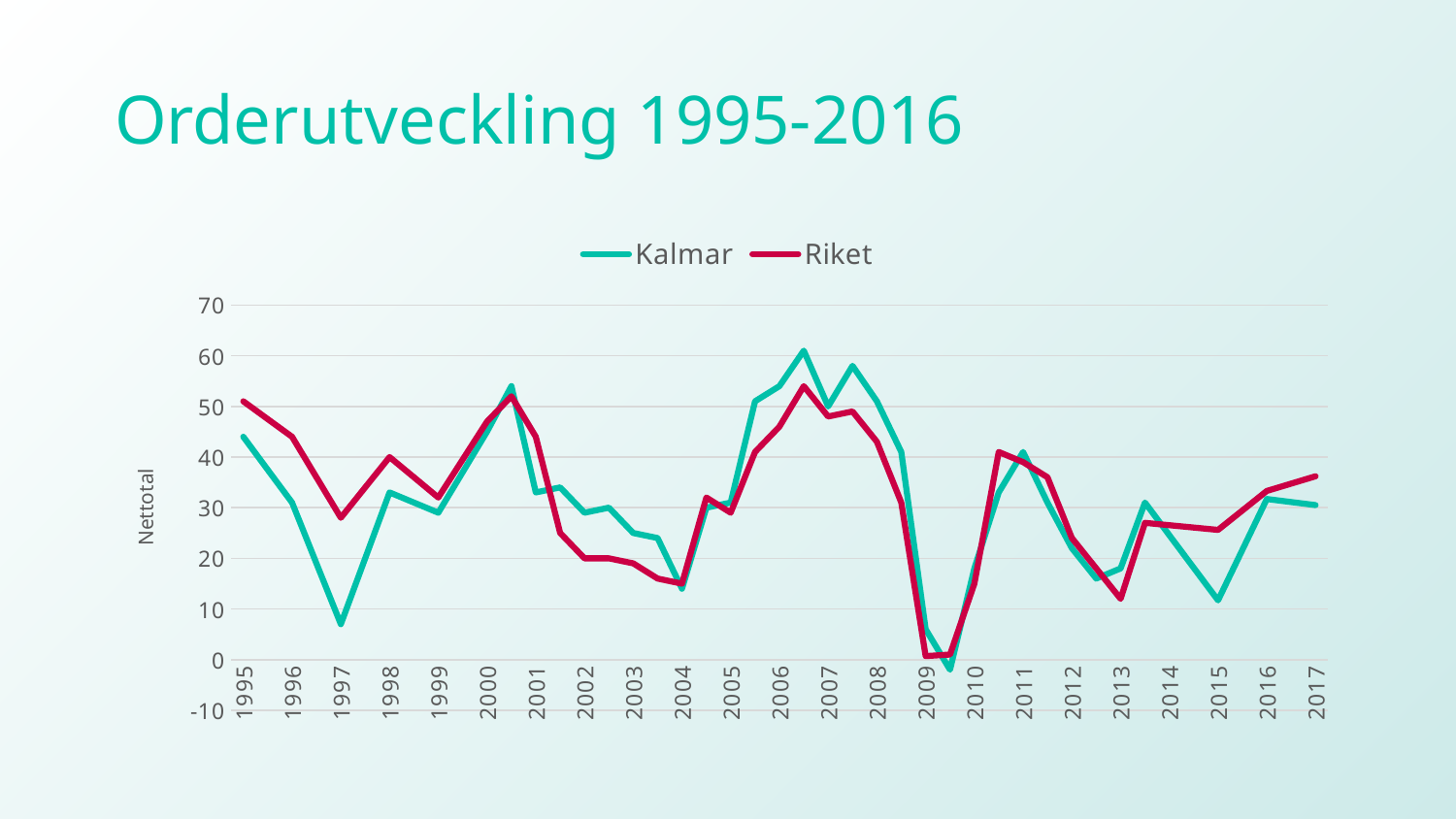
How many series does the legend list? 2 In 1997, which series has the higher value, Kalmar or Riket? Riket What are the two series named in the legend? Kalmar and Riket What kind of chart is shown on the slide? line chart Is the value for Kalmar in 1997 greater or less than 10? less Is the value for Riket in 1997 greater or less than 30? less Does the Kalmar line rise or fall from 1995 to 1997? fall In 2007, which series has the higher value, Kalmar or Riket? Kalmar Is the value for Kalmar in 2015 greater or less than 20? less What is the title of the chart? Orderutveckling 1995-2016 Does the Riket line rise or fall from 2013 to 2017? rise